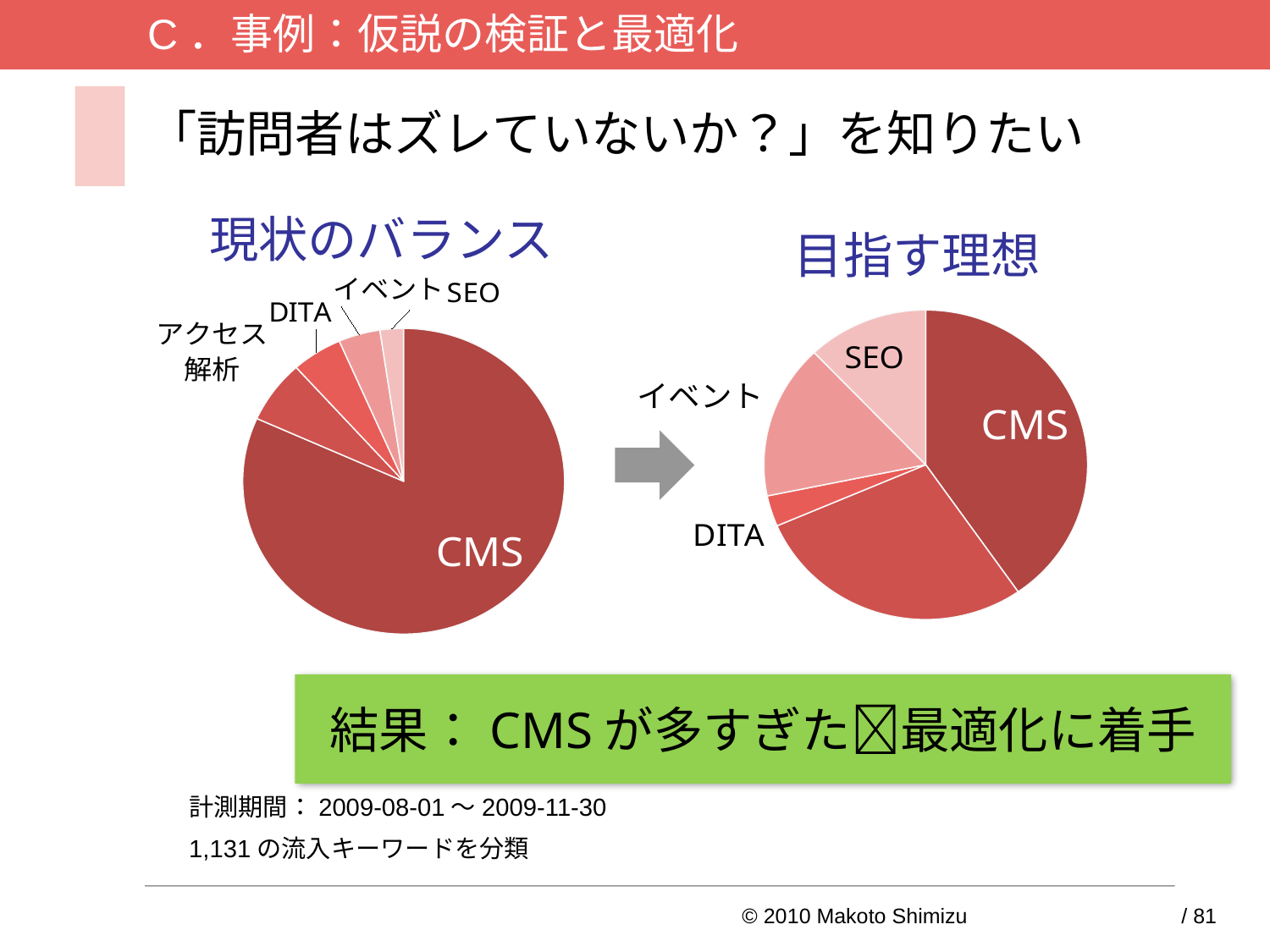
In the "現状のバランス" pie chart, which slice is larger, アクセス解析 or SEO? アクセス解析 In the "目指す理想" pie chart, which labeled category has the smallest slice? DITA In the "目指す理想" pie chart, which slice is larger, イベント or DITA? イベント What is the title of the pie chart on the right? 目指す理想 In the "現状のバランス" pie chart, which category has the largest slice? CMS In the "目指す理想" pie chart, which slice is larger, CMS or SEO? CMS In the "目指す理想" pie chart, which category has the largest slice? CMS What is the title of the pie chart on the left? 現状のバランス What kind of chart is the "目指す理想" chart on the right? pie chart In the "現状のバランス" pie chart, how many labeled slices are there? 5 What kind of chart is the "現状のバランス" chart on the left? pie chart